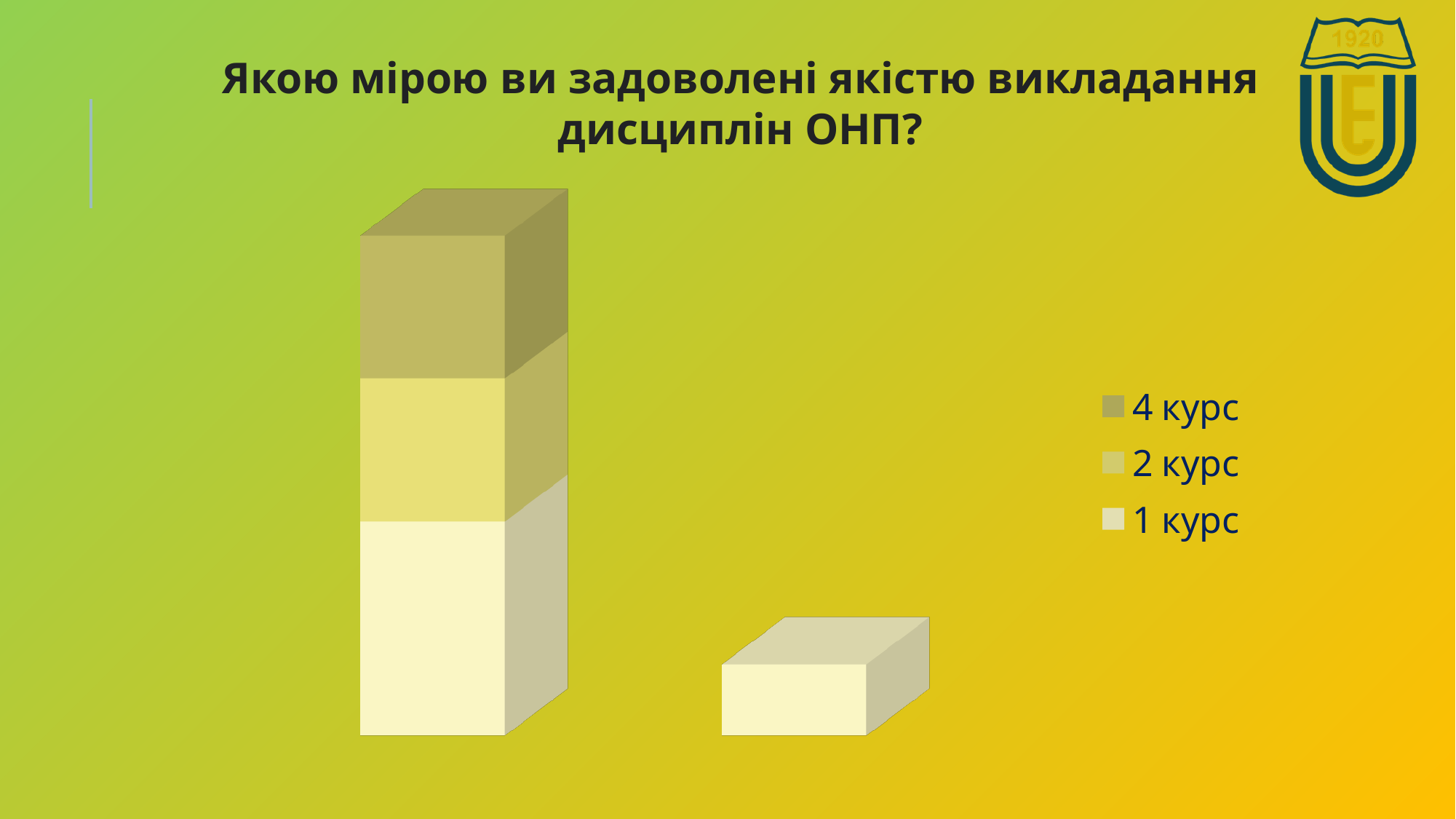
Which bar is taller, the left bar or the right bar? the left bar How many bars are plotted in the chart? 2 What are the three entries listed in the legend? 4 курс, 2 курс, 1 курс What kind of chart is shown on the slide? bar chart How many series does the legend list? 3 Which series is shown at the top of the left stacked bar? 4 курс